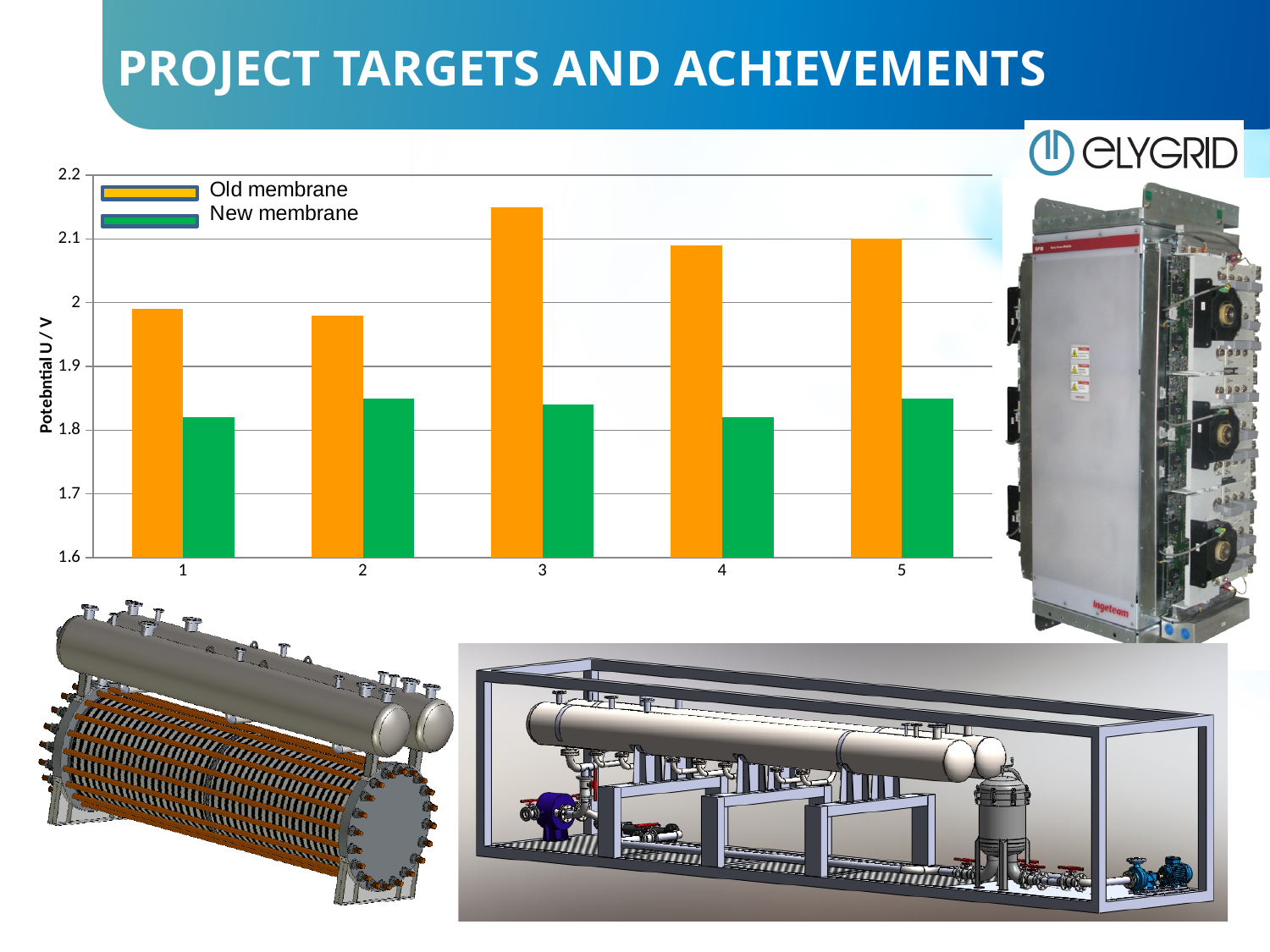
Which is larger, the Old membrane value for category 3 or the Old membrane value for category 4? category 3 Is the Old membrane value for category 2 greater or less than 2? less How many series does the chart's legend list? 2 For which category is the Old membrane value highest? 3 Is the New membrane value for category 3 greater or less than 1.8? greater What kind of chart is shown on the slide? bar chart How many categories are shown along the x axis of the chart? 5 Is the Old membrane value for category 3 greater or less than 2.1? greater For category 1, which series has the larger value, Old membrane or New membrane? Old membrane What is the label of the chart's y axis? Potebntial U / V What are the two series named in the chart's legend? Old membrane and New membrane